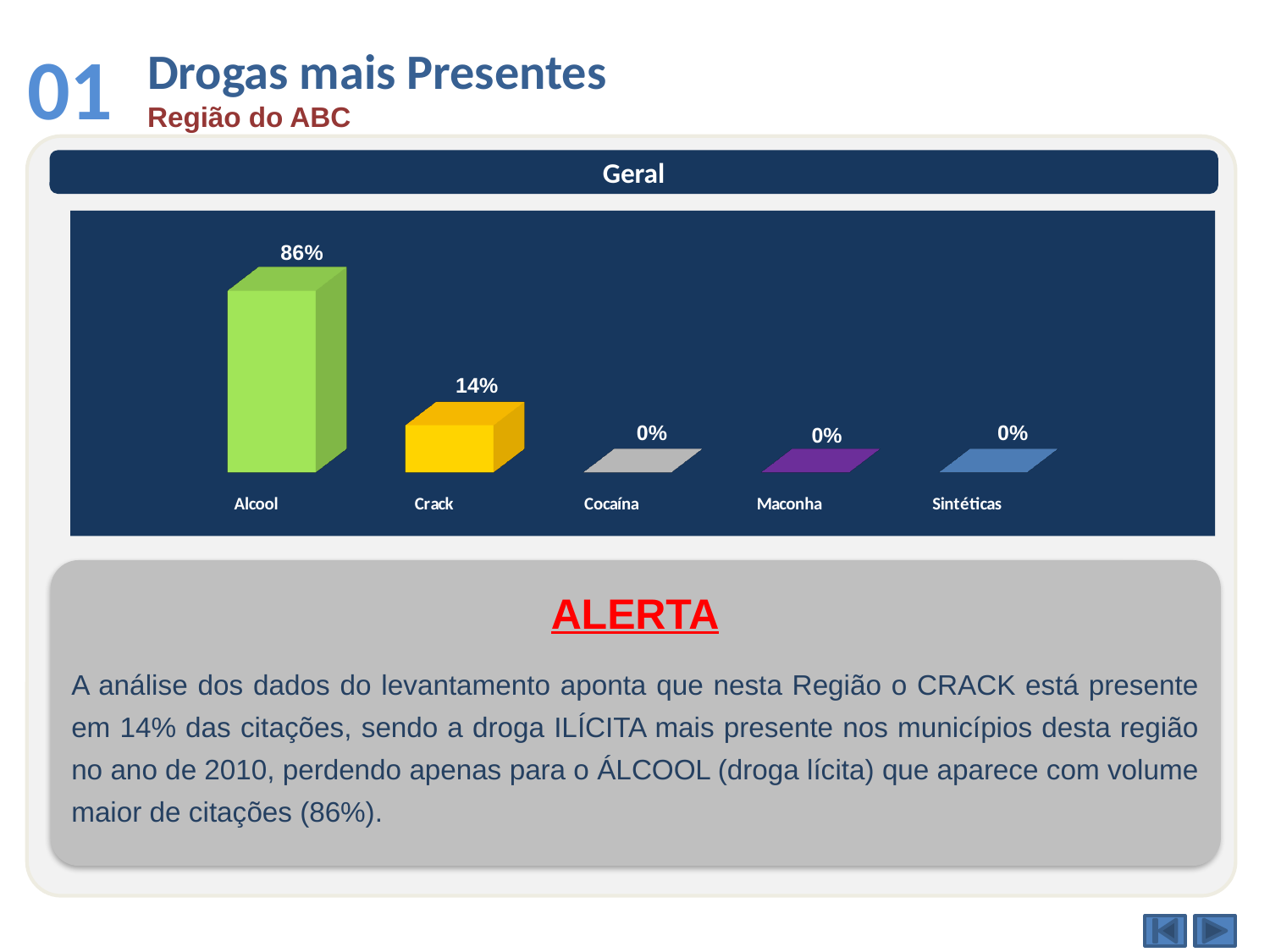
What is the value for Crack? 14% Do the values rise or fall from left to right along the x axis? Fall What is the value for Maconha? 0% What is the value for Alcool? 86% Which category has the highest value? Alcool What kind of chart is shown? Bar chart How many categories are shown on the x axis? 5 What is the difference between the values for Alcool and Crack? 72% Which is larger, the value for Crack or the value for Sintéticas? Crack How many categories have a value of 0%? 3 What is the title shown above the chart? Geral What is the value for Cocaína? 0%